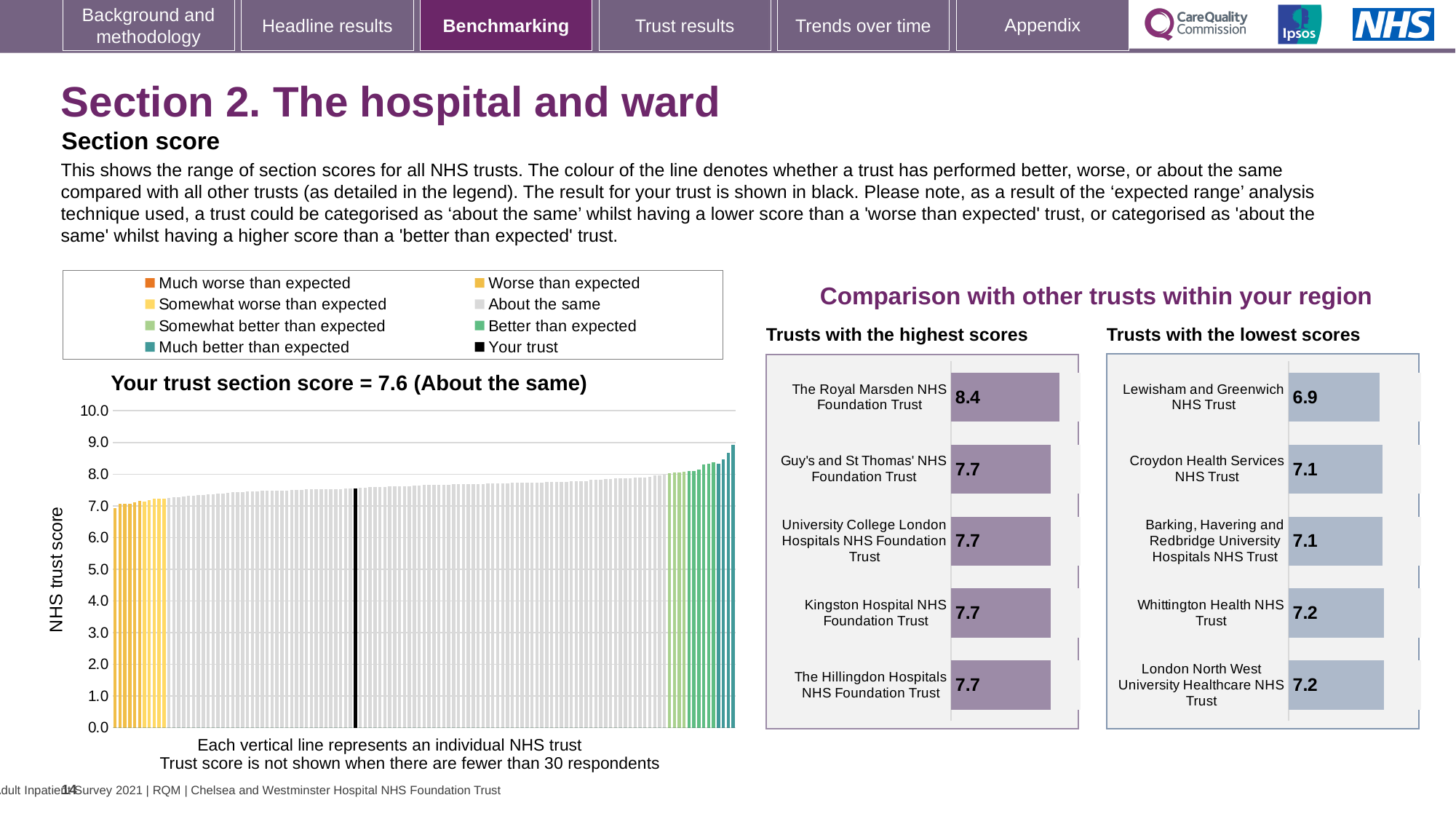
Which has the larger score: Croydon Health Services NHS Trust in the 'Trusts with the lowest scores' chart or Guy's and St Thomas' NHS Foundation Trust in the 'Trusts with the highest scores' chart? Guy's and St Thomas' NHS Foundation Trust In the 'Trusts with the highest scores' chart, which trust has the highest score? The Royal Marsden NHS Foundation Trust In the 'Your trust section score' chart, do the bar heights rise or fall from left to right? rise How many entries does the legend above the 'Your trust section score' chart list? 8 In the 'Your trust section score' chart, what is the section score for your trust? 7.6 In the 'Trusts with the lowest scores' chart, which trust has the lowest score? Lewisham and Greenwich NHS Trust What kind of chart is the 'Your trust section score' chart on the left of the slide? bar chart In the 'Trusts with the highest scores' chart, what is the score for The Royal Marsden NHS Foundation Trust? 8.4 In the 'Trusts with the highest scores' chart, what is the difference between the scores of The Royal Marsden NHS Foundation Trust and Kingston Hospital NHS Foundation Trust? 0.7 In the 'Trusts with the lowest scores' chart, what is the score for Lewisham and Greenwich NHS Trust? 6.9 In the 'Your trust section score' chart, is the value of the rightmost (tallest) bar greater or less than 8.0? greater In the 'Trusts with the highest scores' chart, how many trusts are shown? 5